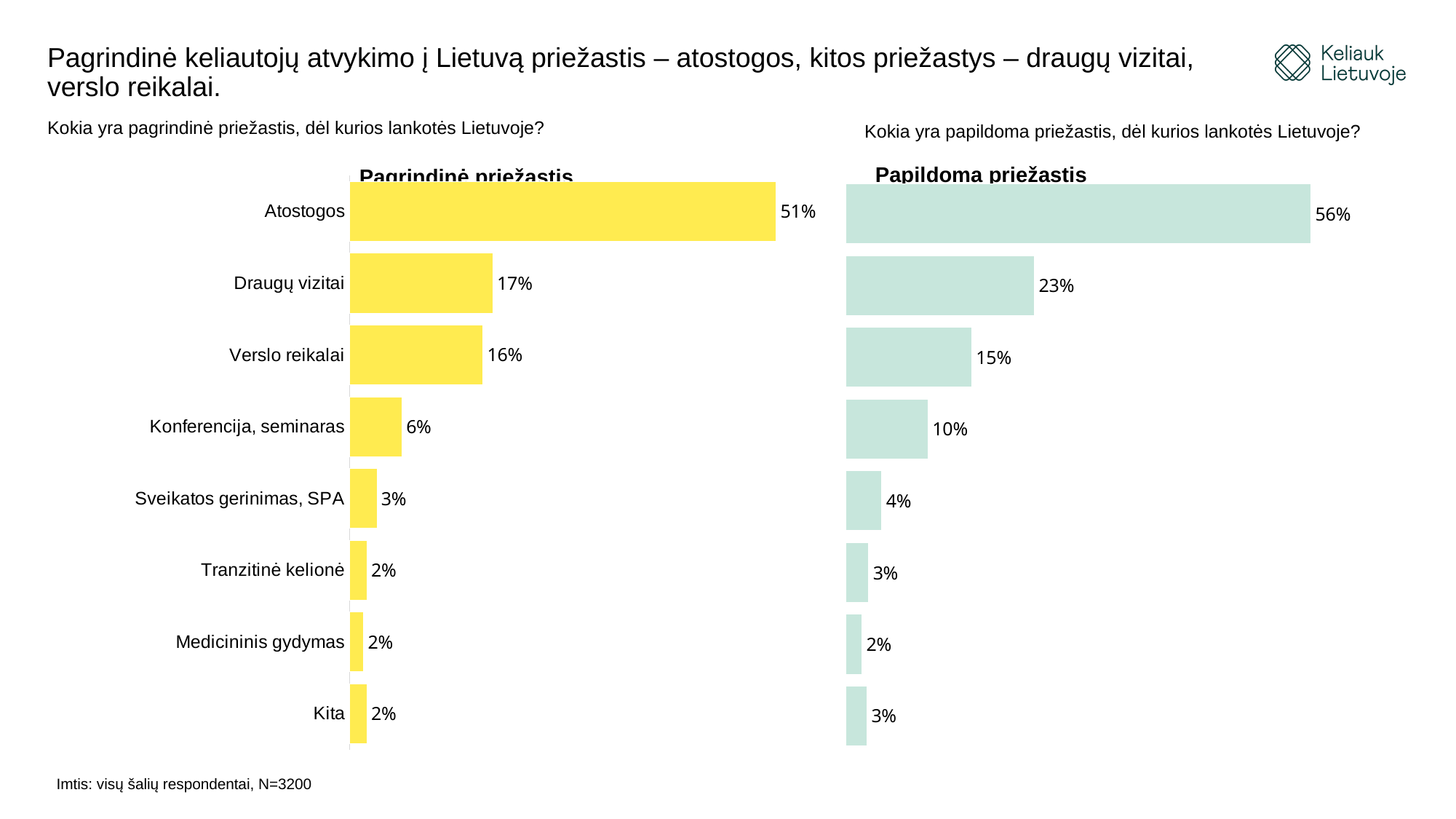
In the "Papildoma priežastis" chart, what is the value for Draugų vizitai? 23% In the "Papildoma priežastis" chart, which category has the highest value? Atostogos What type of chart is the "Papildoma priežastis" chart? Bar chart In the "Papildoma priežastis" chart, what is the difference between Verslo reikalai and Konferencija, seminaras? 5 percentage points In the "Pagrindinė priežastis" chart, what is the value for Atostogos? 51% In the "Papildoma priežastis" chart, what is the value for Konferencija, seminaras? 10% How many categories does the "Pagrindinė priežastis" chart show? 8 In the "Pagrindinė priežastis" chart, what is the difference between Atostogos and Draugų vizitai? 34 percentage points Which is larger: Verslo reikalai in the "Pagrindinė priežastis" chart or Verslo reikalai in the "Papildoma priežastis" chart? Pagrindinė priežastis What colour are the bars in the "Pagrindinė priežastis" chart? Yellow In the "Papildoma priežastis" chart, which category has the lowest value? Medicininis gydymas In the "Pagrindinė priežastis" chart, what is the value for Sveikatos gerinimas, SPA? 3%